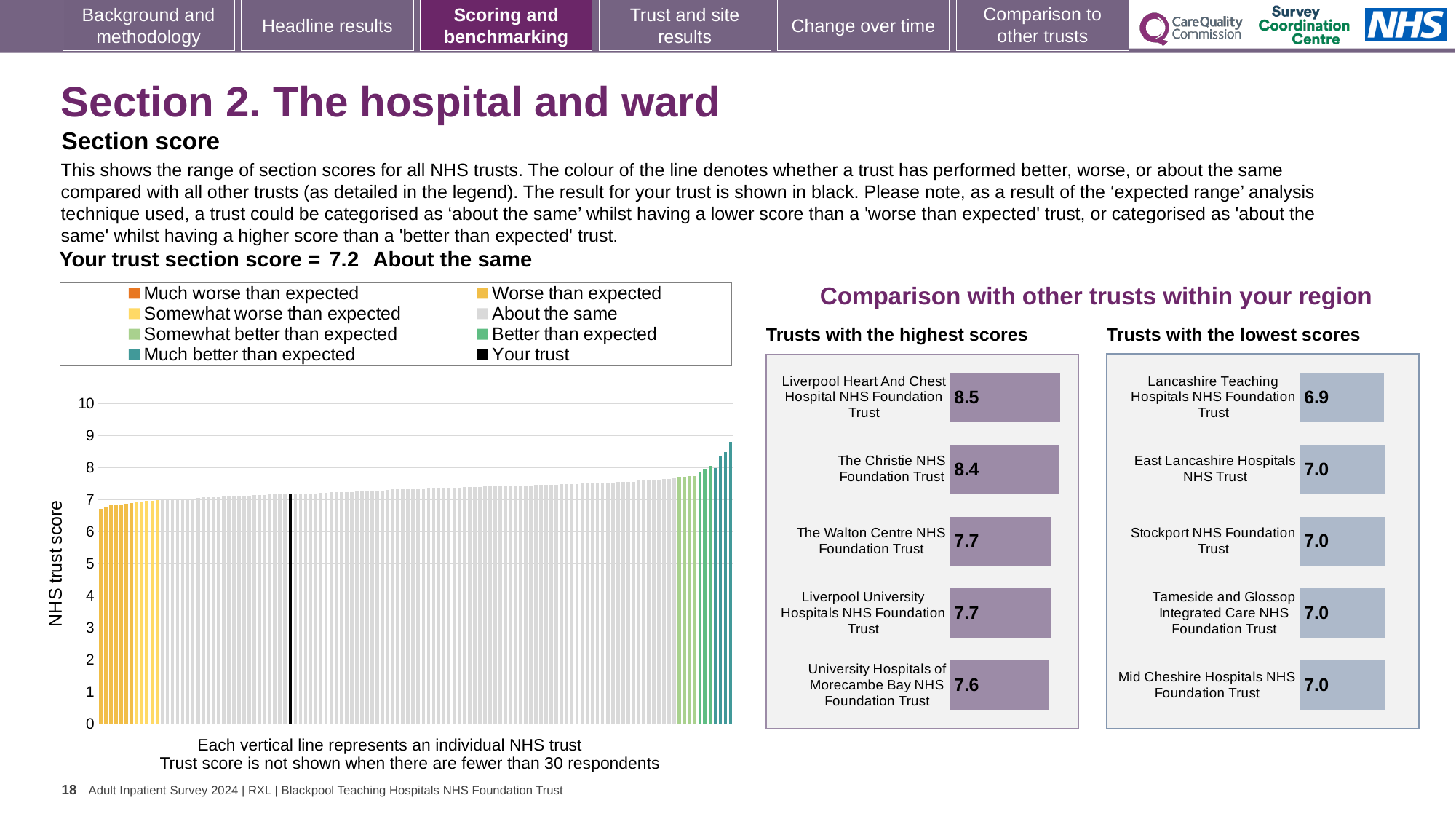
In the 'Trusts with the highest scores' chart, what is the difference between the scores of Liverpool Heart And Chest Hospital NHS Foundation Trust and University Hospitals of Morecambe Bay NHS Foundation Trust? 0.9 In the 'Trusts with the highest scores' chart, how many trusts are listed? 5 In the main chart of NHS trust scores on the left, what kind of chart is it? Bar chart In the 'Trusts with the highest scores' chart, what is the score for Liverpool Heart And Chest Hospital NHS Foundation Trust? 8.5 In the 'Trusts with the lowest scores' chart, which trust has the lowest score? Lancashire Teaching Hospitals NHS Foundation Trust In the 'Trusts with the highest scores' chart, what is the score for The Christie NHS Foundation Trust? 8.4 In the 'Trusts with the highest scores' chart, which trust has the lowest score shown? University Hospitals of Morecambe Bay NHS Foundation Trust In the main chart of NHS trust scores on the left, do the bars rise or fall from left to right? Rise In the 'Trusts with the lowest scores' chart, what is the score for Mid Cheshire Hospitals NHS Foundation Trust? 7.0 In the 'Trusts with the lowest scores' chart, what is the difference between the scores of Stockport NHS Foundation Trust and Lancashire Teaching Hospitals NHS Foundation Trust? 0.1 In the 'Trusts with the lowest scores' chart, what is the score for Lancashire Teaching Hospitals NHS Foundation Trust? 6.9 In the main chart of NHS trust scores on the left, how many entries does the legend list? 8